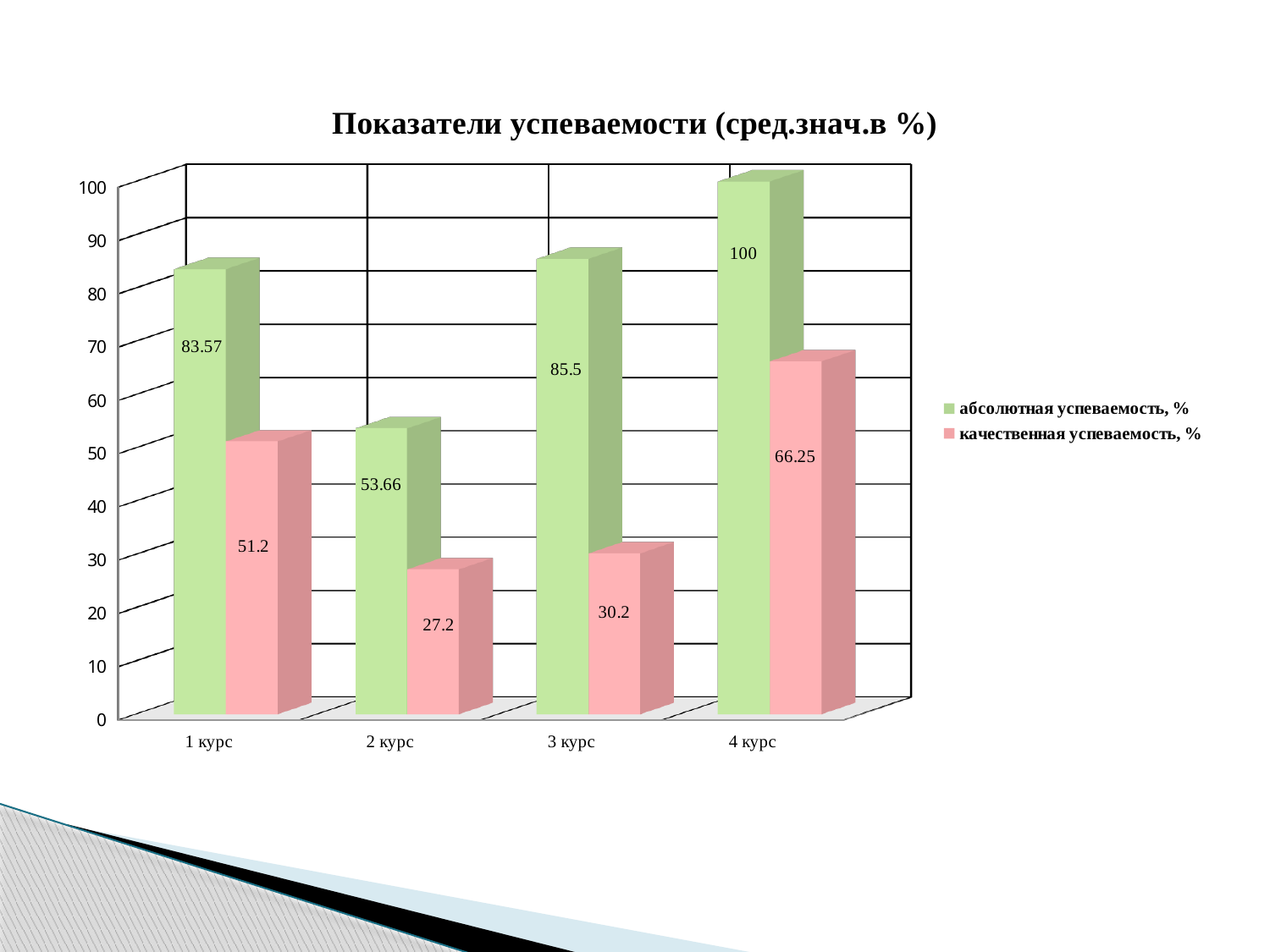
How many series does the legend list? 2 Which is larger: качественная успеваемость, % for 1 курс or for 3 курс? 1 курс What is the value of абсолютная успеваемость, % for 1 курс? 83.57 Which course has the lowest качественная успеваемость, %? 2 курс What is the value of качественная успеваемость, % for 2 курс? 27.2 How many courses are shown on the x axis? 4 What is the difference between абсолютная успеваемость, % and качественная успеваемость, % for 4 курс? 33.75 What is the value of абсолютная успеваемость, % for 3 курс? 85.5 What is the title of the chart? Показатели успеваемости (сред.знач.в %) What kind of chart is shown on the slide? Bar chart What is the value of качественная успеваемость, % for 4 курс? 66.25 Which course has the highest абсолютная успеваемость, %? 4 курс